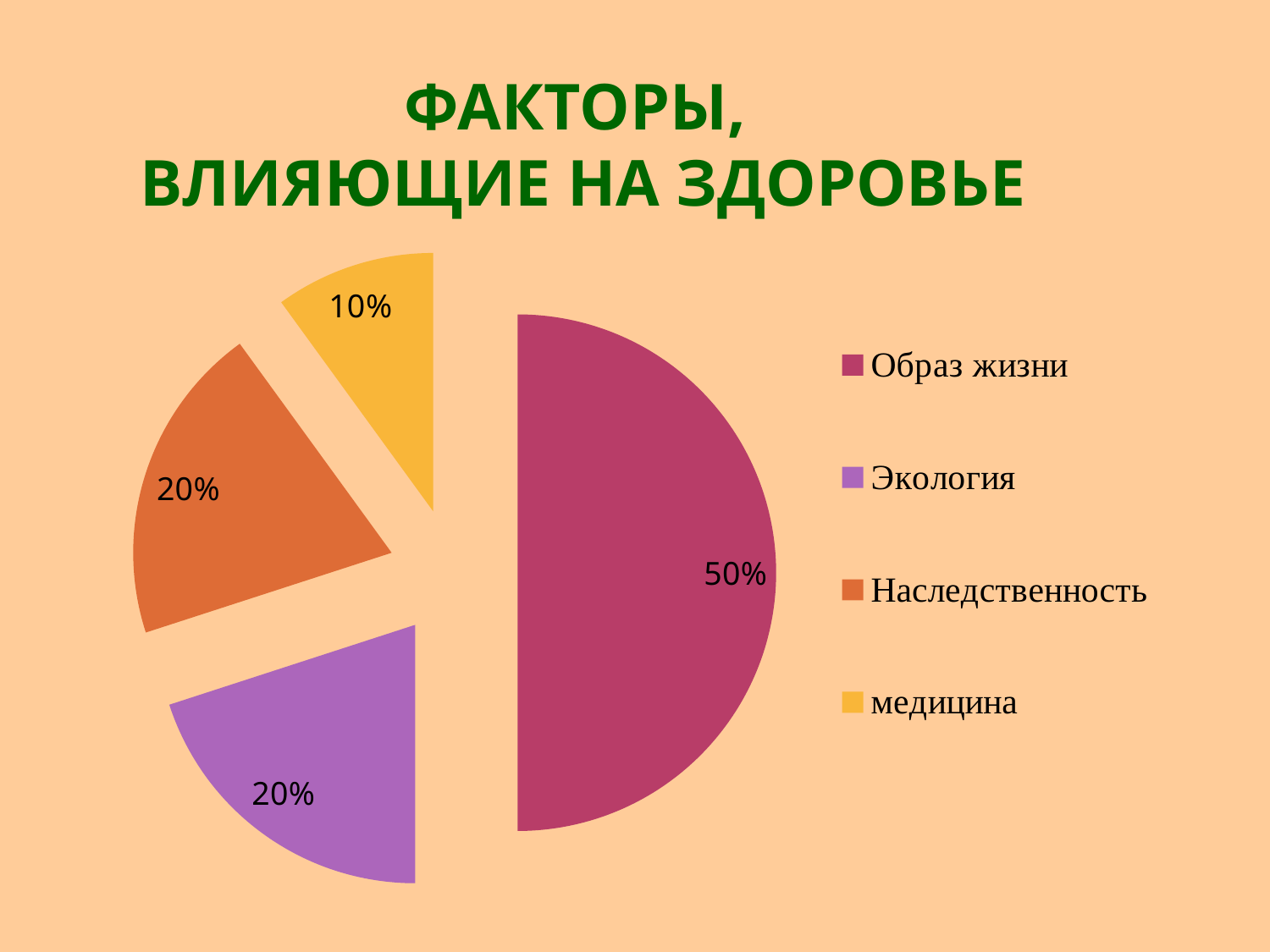
Which category has the smallest slice of the pie? медицина Which category is shown in yellow in the legend? медицина How many categories does the pie chart have? 4 What share of the pie does Образ жизни have? 50% What share of the pie does Наследственность have? 20% Which category has the largest slice of the pie? Образ жизни What share of the pie does Экология have? 20% What is the title of the slide? ФАКТОРЫ, ВЛИЯЮЩИЕ НА ЗДОРОВЬЕ Which is larger, the share of Экология or the share of медицина? Экология What share of the pie does медицина have? 10% What kind of chart is shown on the slide? pie chart What is the difference between the shares of Образ жизни and медицина? 40%